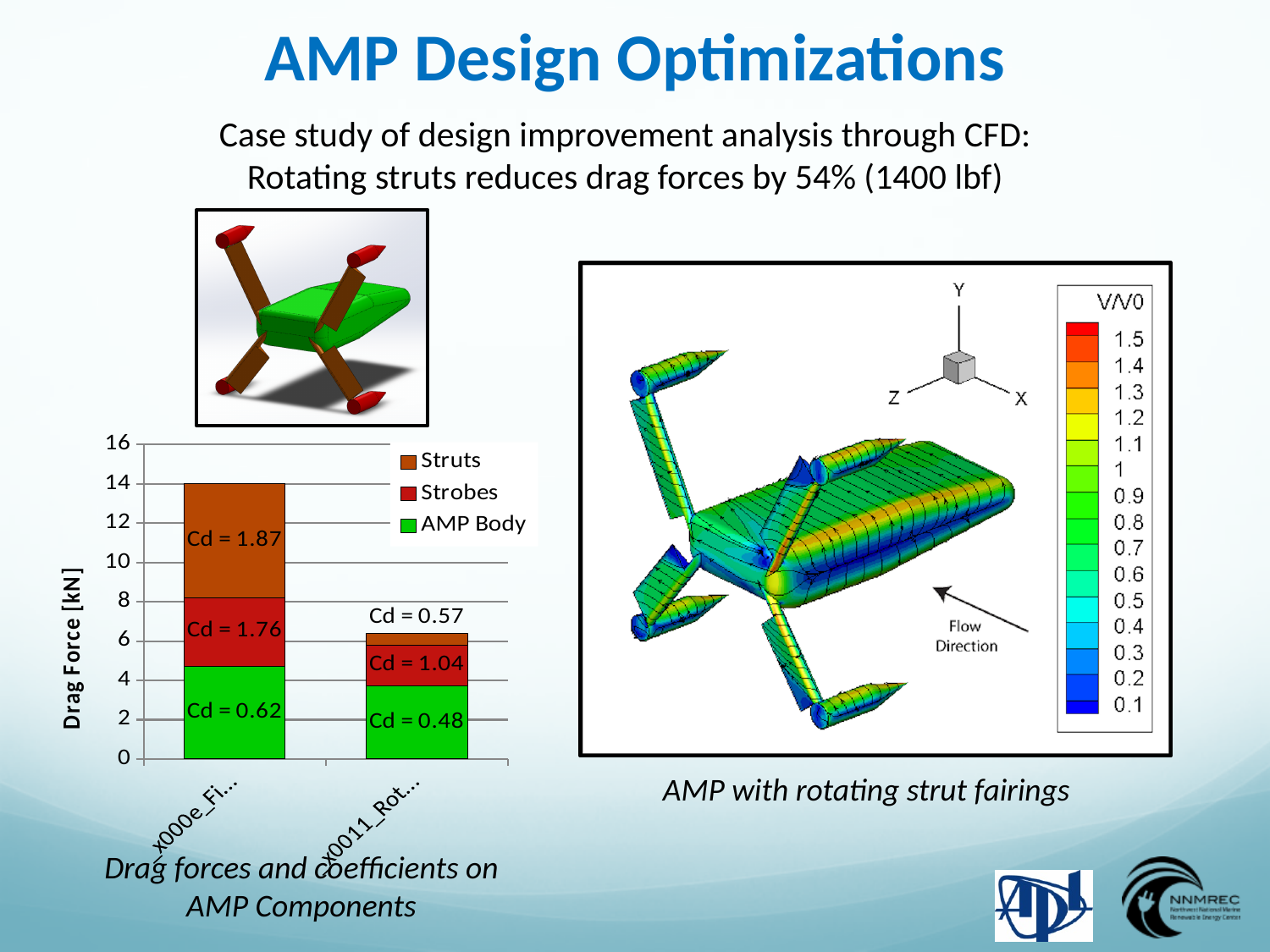
Is the total drag force of the right bar greater or less than 8 kN? less What is the Cd value labelled on the AMP Body segment of the left bar? Cd = 0.62 Which of the two bars has the greater total drag force? The left bar What kind of chart is shown on the slide? Stacked bar chart What is the Cd value labelled on the Struts segment of the left bar? Cd = 1.87 Which component has the lowest Cd value in the right bar? AMP Body What is the Cd value labelled on the Strobes segment of the right bar? Cd = 1.04 What is the title of the vertical axis of the chart? Drag Force [kN] How many series does the chart legend list? 3 How many bars are plotted in the chart? 2 What is the Cd value labelled on the Struts segment of the right bar? Cd = 0.57 Is the total drag force of the left bar greater or less than 12 kN? greater